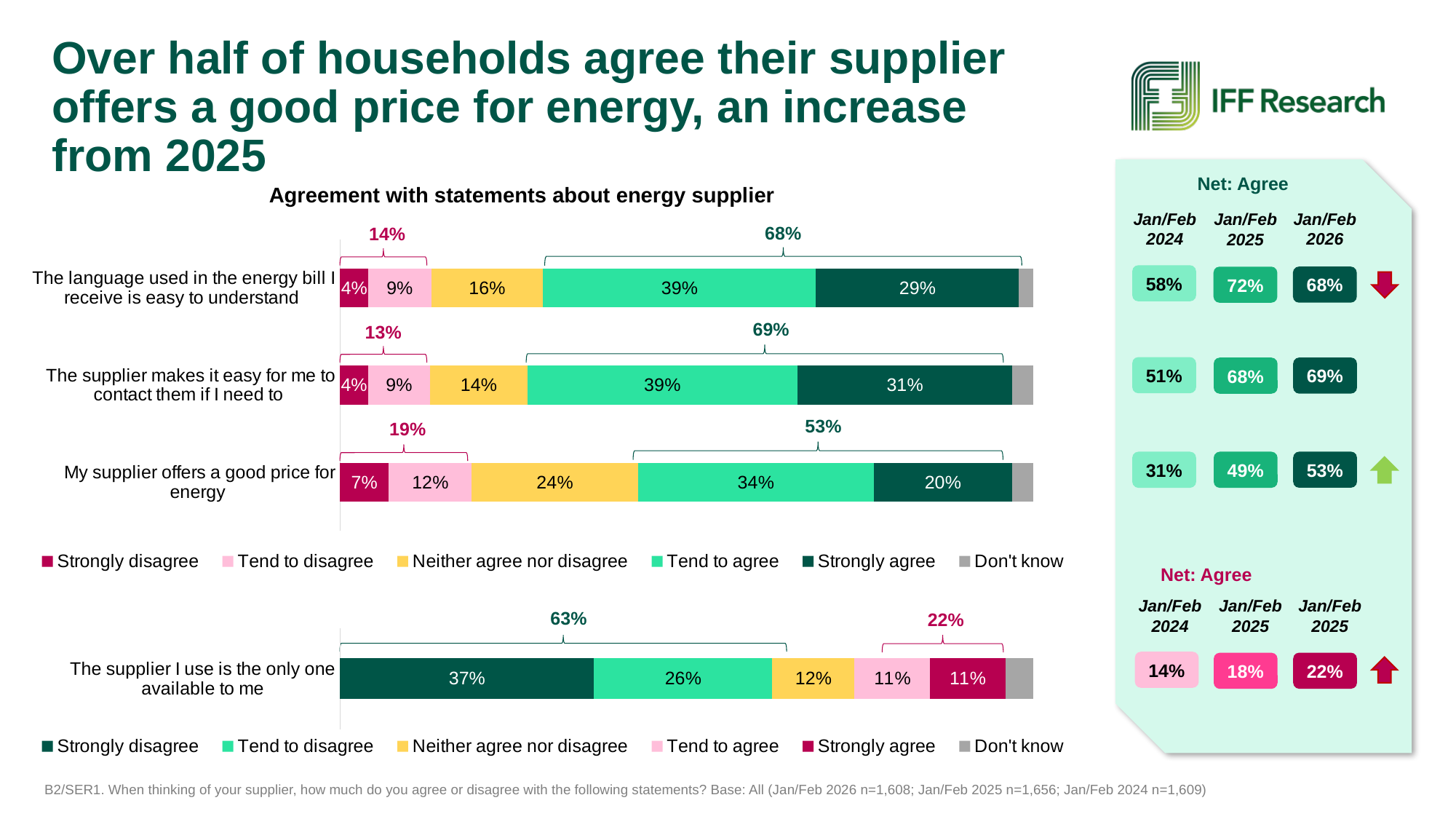
In the top chart, which statement has the lowest 'Tend to agree' percentage? My supplier offers a good price for energy In the top chart, what percentage neither agree nor disagree that 'The language used in the energy bill I receive is easy to understand'? 16% In the top chart, which statement has a larger 'Strongly disagree' percentage: 'My supplier offers a good price for energy' or 'The language used in the energy bill I receive is easy to understand'? My supplier offers a good price for energy In the top chart 'Agreement with statements about energy supplier', what percentage strongly agree that 'My supplier offers a good price for energy'? 20% In the top chart, what is the net agree percentage shown above the bar for 'My supplier offers a good price for energy'? 53% How many statements are plotted in the top chart 'Agreement with statements about energy supplier'? 3 What kind of chart is the bottom chart for 'The supplier I use is the only one available to me'? Stacked bar chart How many series does the legend of the top chart list? 6 In the bottom chart, what percentage strongly disagree that 'The supplier I use is the only one available to me'? 37% In the bottom chart, what is the combined percentage of 'Strongly disagree' and 'Tend to disagree' for 'The supplier I use is the only one available to me'? 63% In the top chart, which statement has the highest 'Strongly agree' percentage? The supplier makes it easy for me to contact them if I need to In the top chart, what is the difference in the 'Neither agree nor disagree' percentage between 'My supplier offers a good price for energy' and 'The supplier makes it easy for me to contact them if I need to'? 10 percentage points